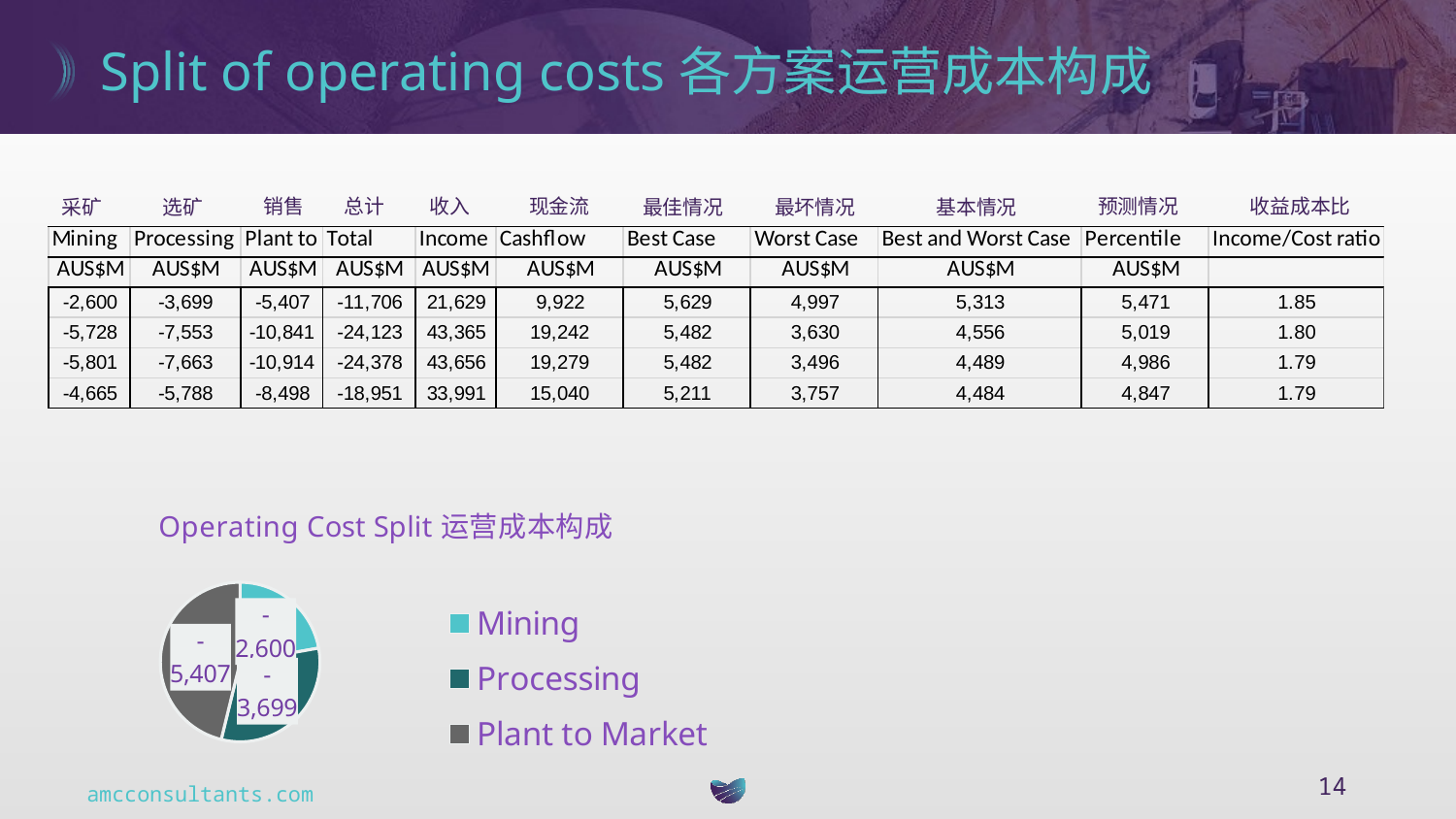
What are the three legend entries of the Operating Cost Split pie chart, in order? Mining, Processing, Plant to Market What type of chart is shown under the heading "Operating Cost Split"? pie chart Which category takes the smallest slice of the Operating Cost Split pie chart? Mining How many series does the legend of the Operating Cost Split pie chart list? 3 What value is labelled on the Processing slice of the Operating Cost Split pie chart? -3,699 What value is labelled on the Mining slice of the Operating Cost Split pie chart? -2,600 In the Operating Cost Split pie chart, what is the difference in magnitude between the Plant to Market slice (5,407) and the Mining slice (2,600)? 2,807 What is the combined magnitude of the three slices in the Operating Cost Split pie chart (2,600 + 3,699 + 5,407)? 11,706 Which category takes the largest slice of the Operating Cost Split pie chart? Plant to Market In the Operating Cost Split pie chart, which slice is larger in magnitude: Processing or Mining? Processing What value is labelled on the Plant to Market slice of the Operating Cost Split pie chart? -5,407 How many slices does the Operating Cost Split pie chart have? 3